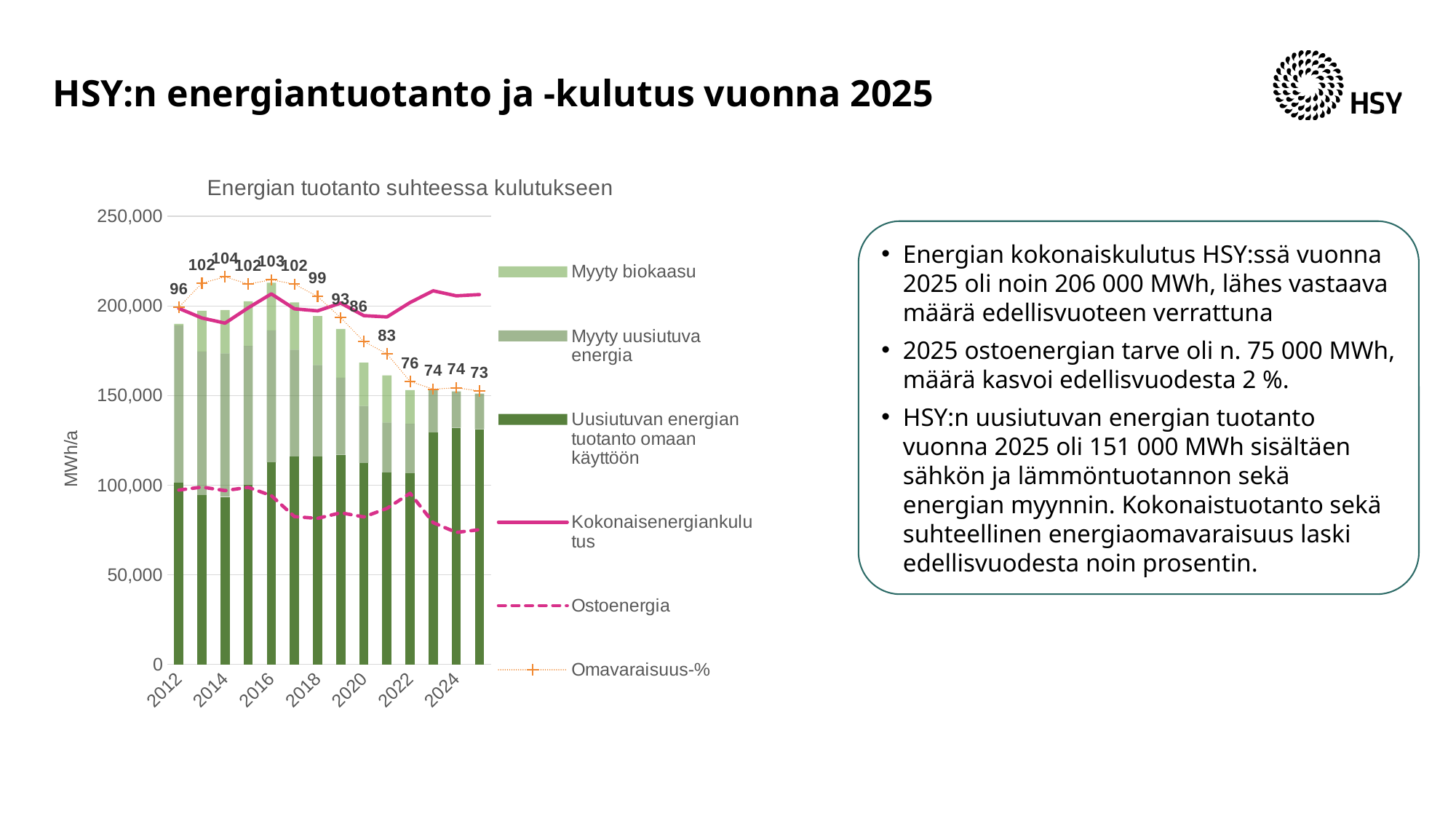
In which year is the Omavaraisuus-% highest? 2014 What is the Omavaraisuus-% value for 2012? 96 What is the difference between the Omavaraisuus-% values for 2012 and 2025? 23 What kind of chart is shown on the slide? Stacked bar chart with line series How many years are shown on the x axis of the chart? 14 Which year has a higher Omavaraisuus-% value, 2014 or 2020? 2014 Is the Ostoenergia value for 2024 greater or less than 100,000? less What is the Omavaraisuus-% value for 2025? 73 Does the Omavaraisuus-% rise or fall from 2017 to 2025? Fall In which year is the Omavaraisuus-% lowest? 2025 How many series does the chart legend list? 6 Is the Uusiutuvan energian tuotanto omaan käyttöön value for 2025 greater or less than 100,000? greater